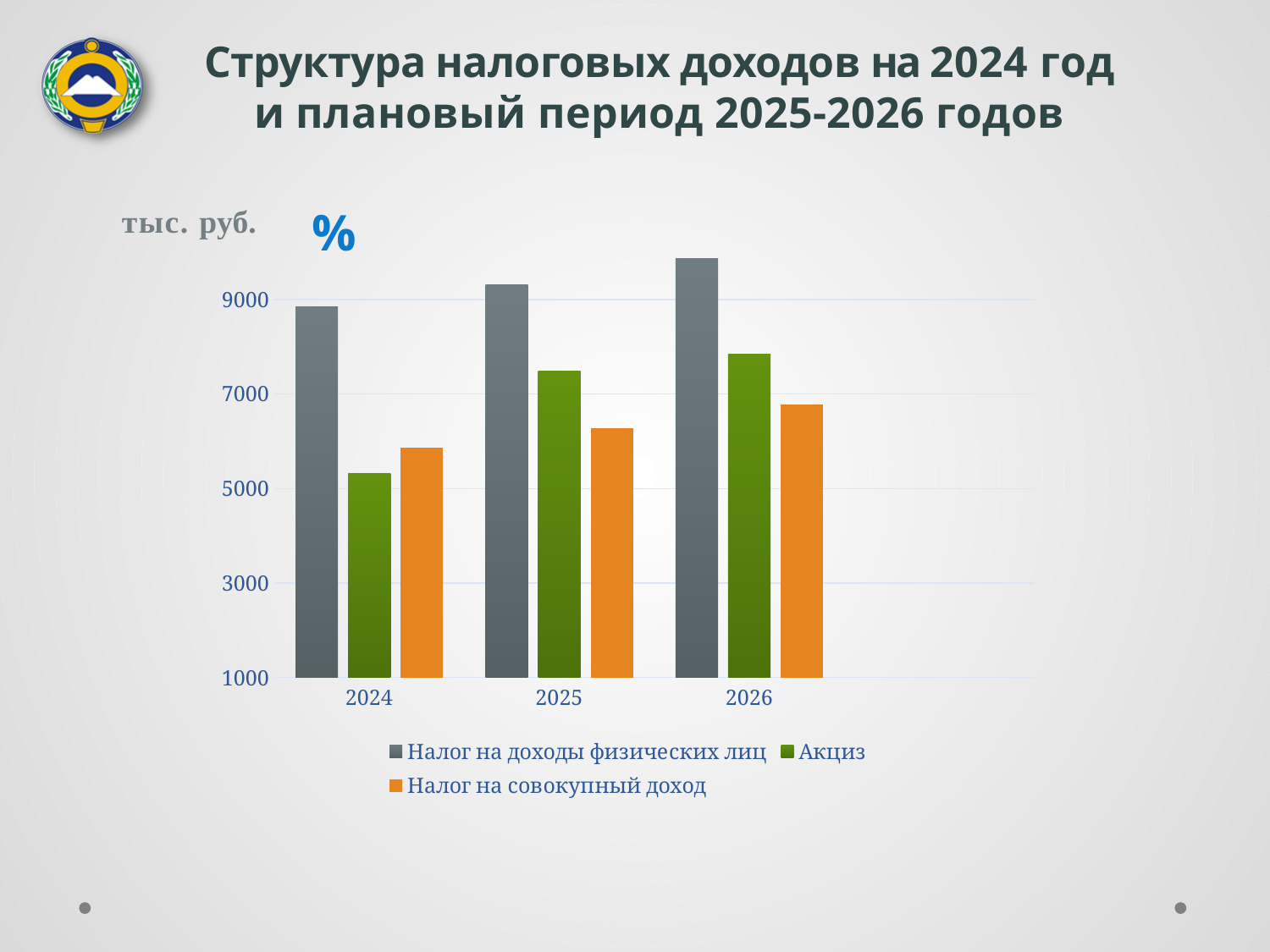
Which series is shown in orange in the legend? Налог на совокупный доход Is the value for Налог на совокупный доход in 2025 greater or less than 7000? less What kind of chart is shown on the slide? bar chart In 2024, which is larger: Акциз or Налог на совокупный доход? Налог на совокупный доход In which year is the bar for Налог на доходы физических лиц the highest? 2026 Is the value for Акциз in 2025 greater or less than 7000? greater How many series does the legend list? 3 How many years are shown on the x axis? 3 Is the value for Налог на доходы физических лиц in 2025 greater or less than 9000? greater In which year is the bar for Акциз the lowest? 2024 Do the values for Налог на доходы физических лиц rise or fall from 2024 to 2026? rise